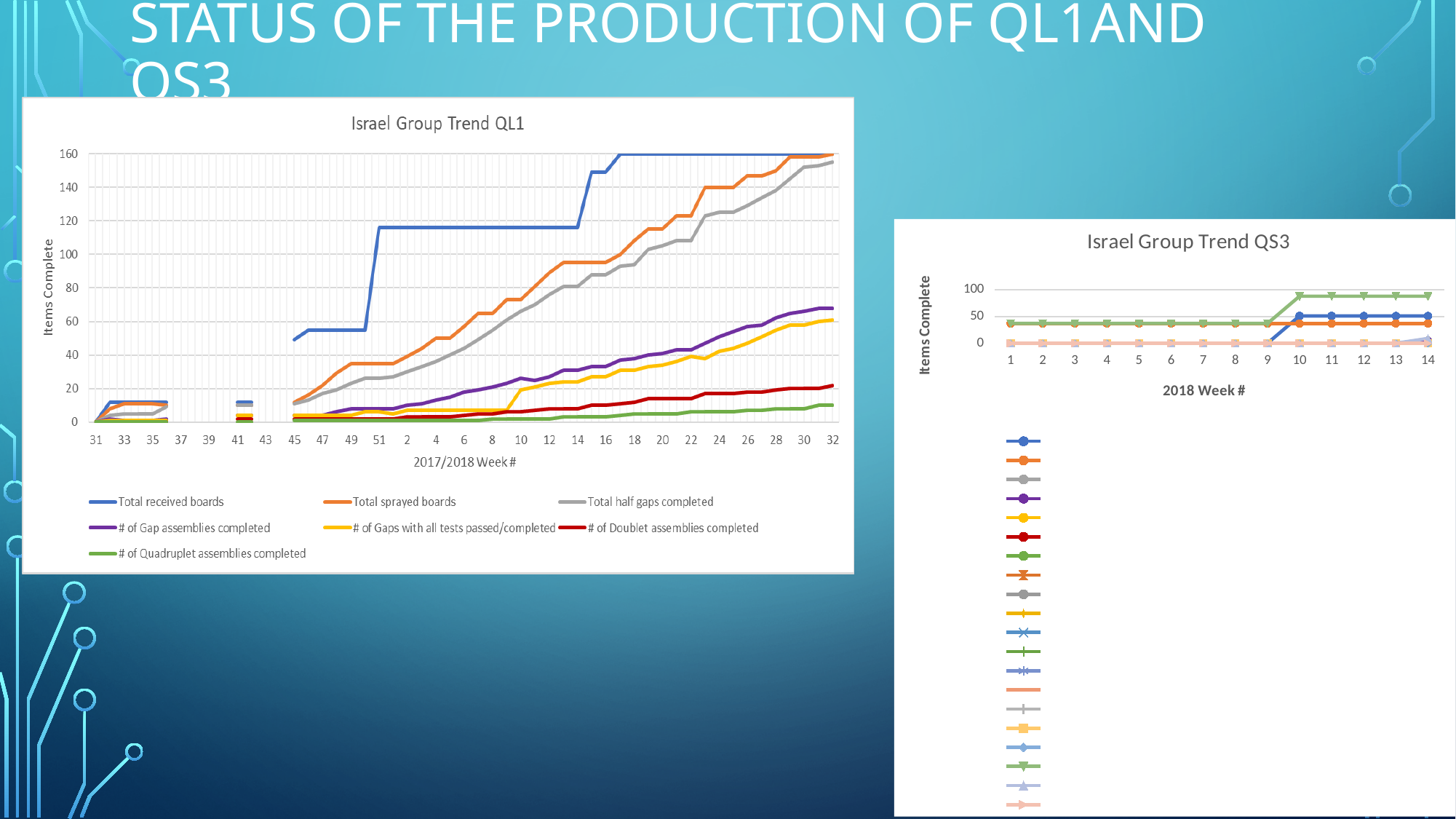
In the 'Israel Group Trend QL1' chart, is the value of Total half gaps completed at week 32 greater or less than 140? greater In the 'Israel Group Trend QL1' chart, is the value of # of Gap assemblies completed at week 32 greater or less than 60? greater What is the y-axis title of the 'Israel Group Trend QL1' chart? Items Complete What type of chart is the 'Israel Group Trend QL1' chart? Line chart How many week points are shown on the x axis of the 'Israel Group Trend QS3' chart? 14 What is the x-axis title of the 'Israel Group Trend QS3' chart? 2018 Week # In the 'Israel Group Trend QL1' chart, is the value of # of Quadruplet assemblies completed at week 32 greater or less than 20? less In the 'Israel Group Trend QL1' chart, what is the value of Total received boards at week 32? 160 In the 'Israel Group Trend QL1' chart, does the Total received boards series rise or fall over the weeks shown? Rise In the 'Israel Group Trend QL1' chart, which is larger at week 32: # of Gap assemblies completed or # of Doublet assemblies completed? # of Gap assemblies completed How many series does the legend of the 'Israel Group Trend QL1' chart list? 7 In the 'Israel Group Trend QL1' chart, which series has the lowest value at week 32? # of Quadruplet assemblies completed